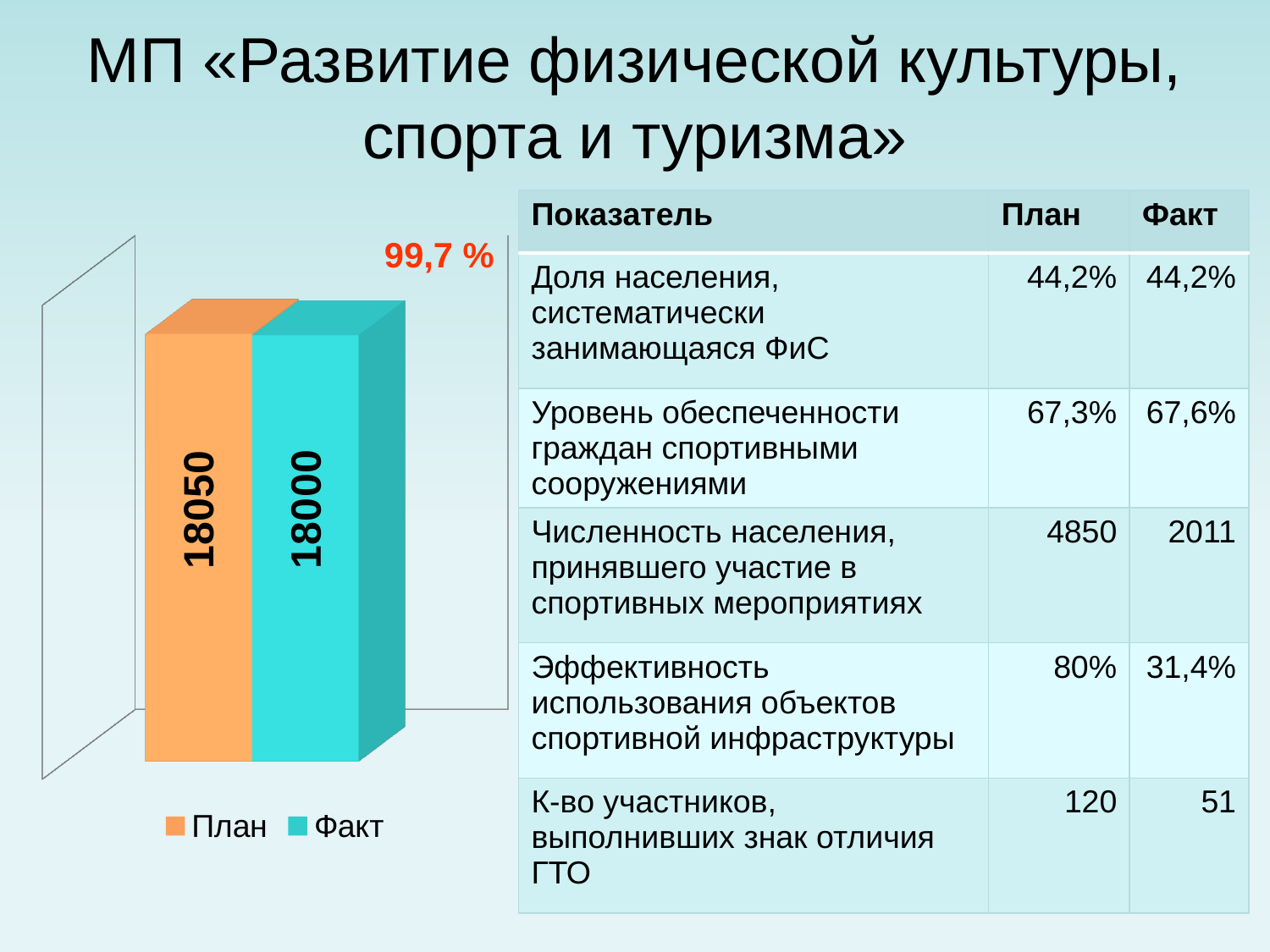
How many series does the chart legend list? 2 What colour is the Факт bar in the chart? teal What is the difference between the План and Факт values in the chart? 50 What is the value of the План bar in the chart? 18050 What kind of chart is shown on the slide? bar chart Which bar in the chart is the lowest? Факт Which series has the higher value in the chart, План or Факт? План What is the value of the Факт bar in the chart? 18000 How many bars are plotted in the chart? 2 What percentage is printed above the bars in the chart? 99,7 %